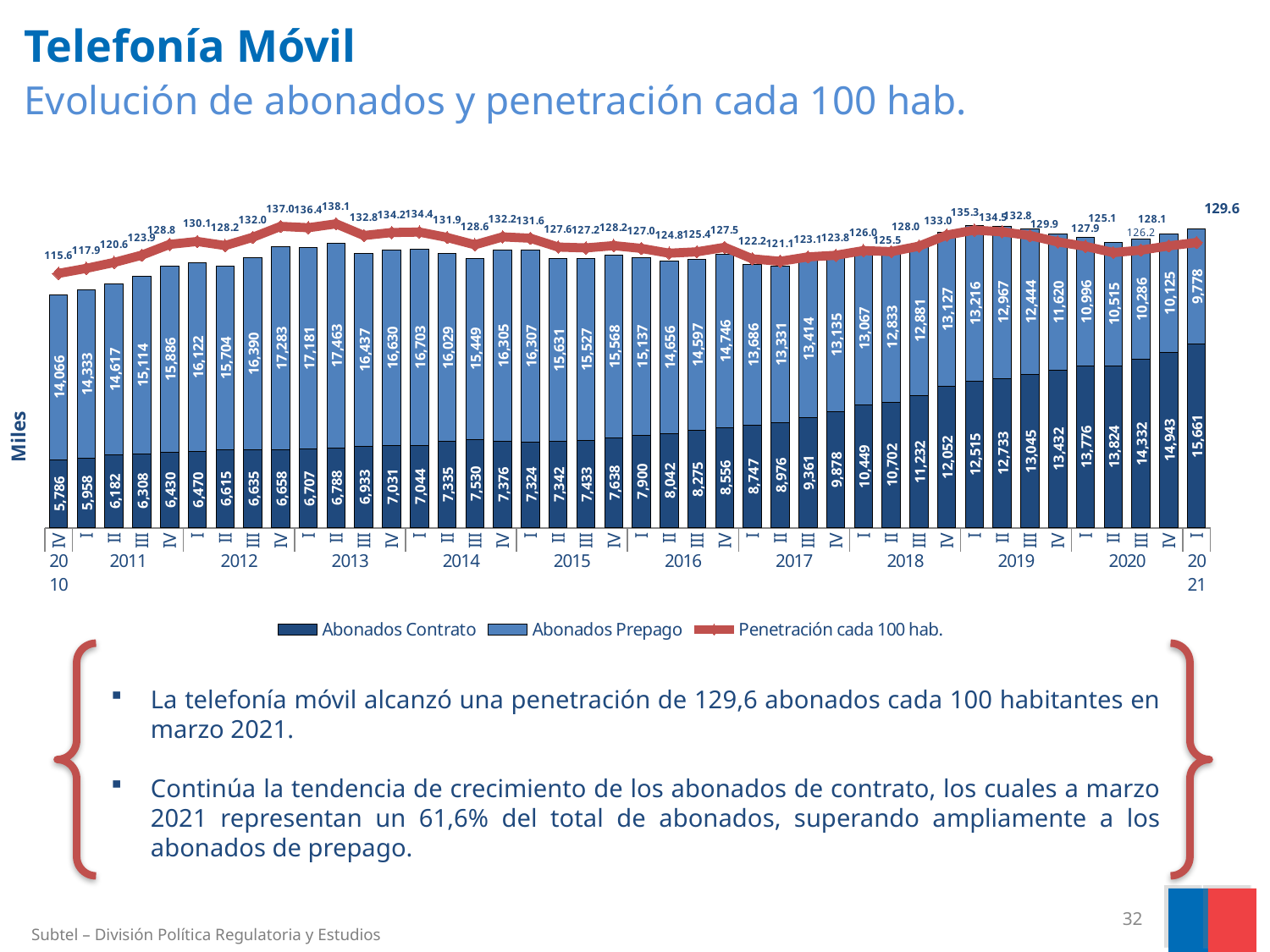
What is the value of Abonados Contrato for I 2021? 15,661 What is the difference between Abonados Contrato and Abonados Prepago in I 2021? 5,883 How many series does the legend list? 3 What is the value of Abonados Prepago for IV 2010? 14,066 How many quarterly bars are plotted in the chart? 42 Which is larger in IV 2010: Abonados Contrato or Abonados Prepago? Abonados Prepago What type of chart is shown on the slide? Stacked bar chart with a line In which quarter does Penetración cada 100 hab. reach its highest value? II 2013 (138.1) In which quarter is Penetración cada 100 hab. lowest? IV 2010 (115.6) What is the highest value of Abonados Prepago, and in which quarter? 17,463 in II 2013 What is the Penetración cada 100 hab. value for I 2021? 129.6 What is the total of the stacked bar for I 2021 (Abonados Contrato plus Abonados Prepago)? 25,439